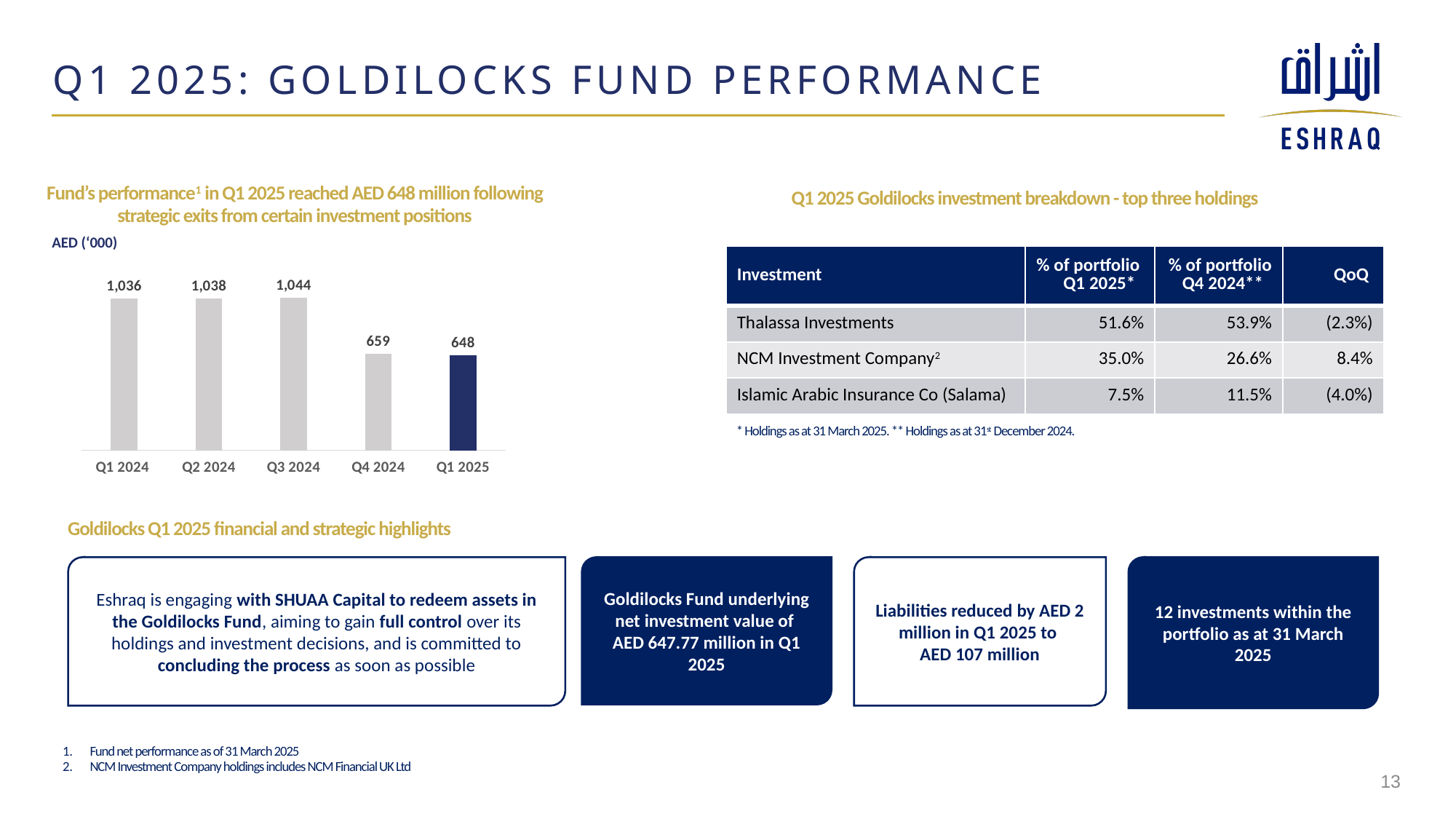
Which is larger in the bar chart, the value for Q2 2024 or the value for Q4 2024? Q2 2024 What is the difference between the Q1 2024 and Q1 2025 values in the bar chart? 388 What is the value for Q4 2024 in the bar chart? 659 What is the value for Q3 2024 in the bar chart? 1,044 Which quarter has the highest value in the bar chart? Q3 2024 What is the difference between the Q4 2024 and Q1 2025 values in the bar chart? 11 What is the value for Q1 2024 in the bar chart? 1,036 What unit is stated for the values in the bar chart? AED ('000) What is the value for Q1 2025 in the bar chart? 648 Which quarter has the lowest value in the bar chart? Q1 2025 What kind of chart is used to show the fund's performance? Bar chart How many quarters are shown in the bar chart? 5